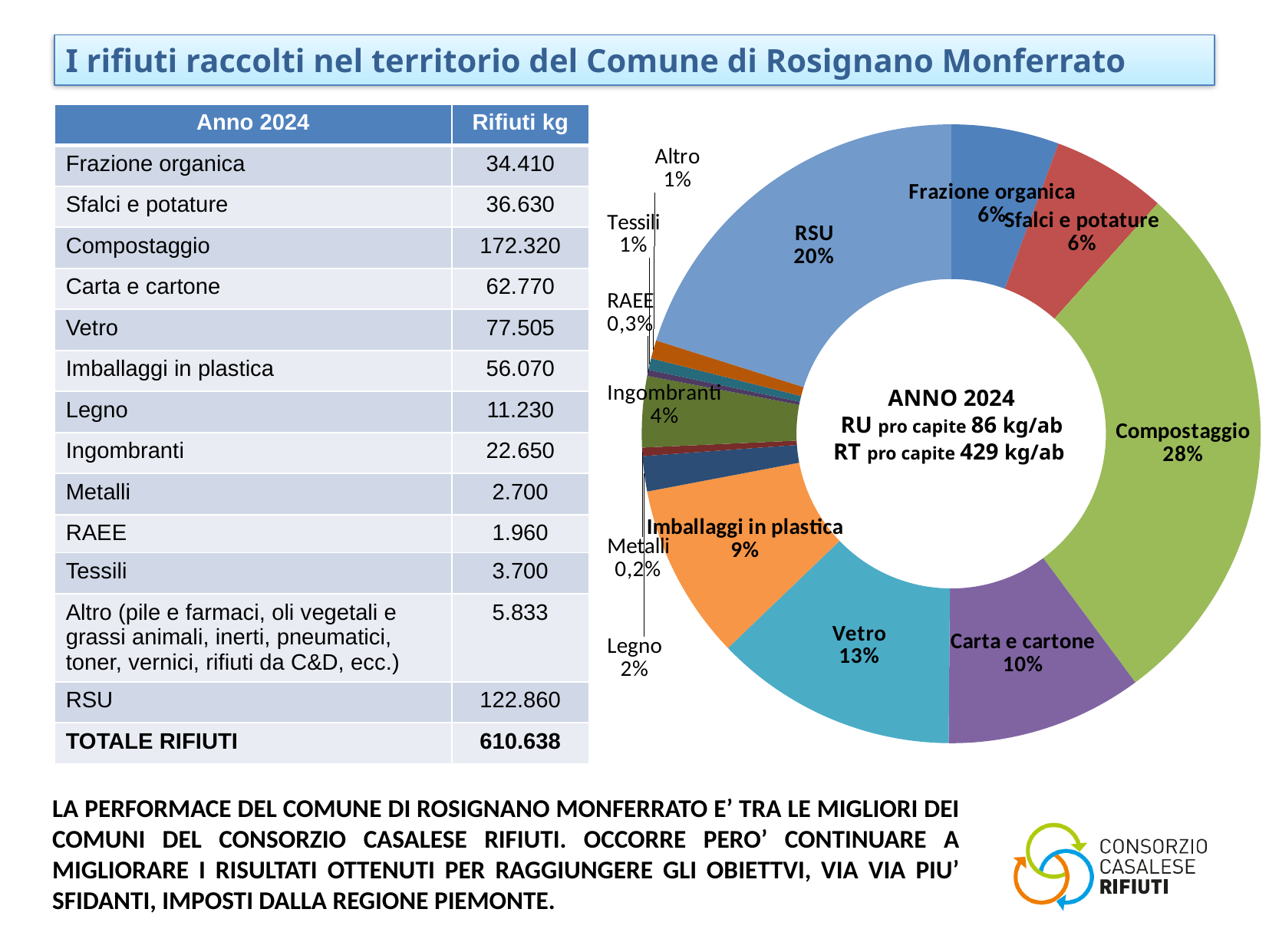
What share of the chart does Compostaggio represent? 28% What percentage is shown for Metalli in the chart? 0,2% Which category has the smallest share in the chart? Metalli Which has a larger share, Imballaggi in plastica or Ingombranti? Imballaggi in plastica What percentage is shown for RSU in the chart? 20% Which category has the largest share in the chart? Compostaggio What year is indicated in the centre of the chart? ANNO 2024 Which has a larger share, Vetro or Carta e cartone? Vetro How many categories are shown in the chart? 13 What percentage is shown for Vetro in the chart? 13% What kind of chart is shown on the slide? Doughnut (pie) chart What is the difference in percentage points between Compostaggio and RSU? 8